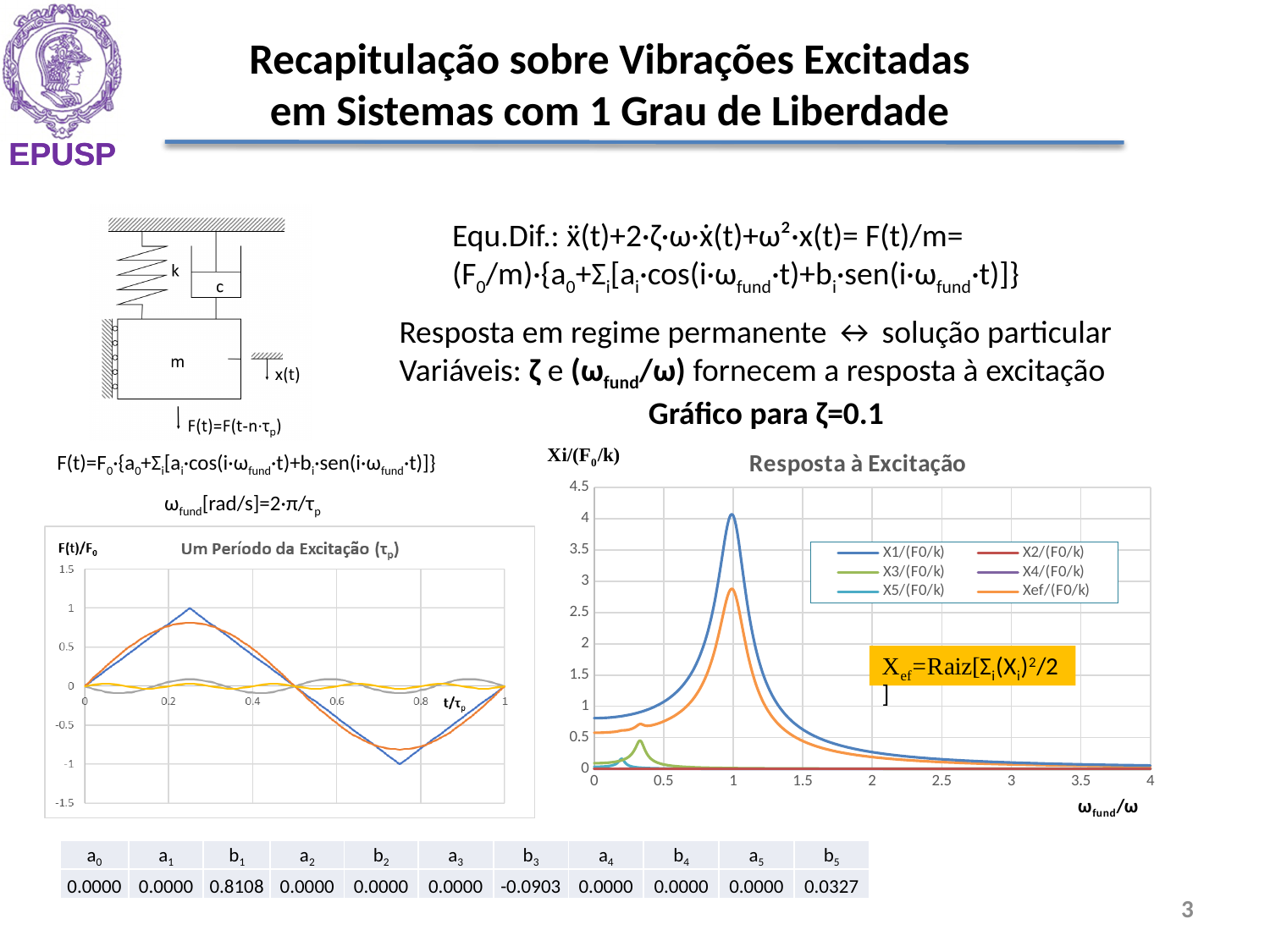
In the 'Resposta à Excitação' chart, at which ωfund/ω value does X1/(F0/k) reach its peak? 1 In the 'Resposta à Excitação' chart, which series reaches the highest peak? X1/(F0/k) In the 'Resposta à Excitação' chart, do the X1/(F0/k) values rise or fall as ωfund/ω increases from 1 to 4? fall What is the highest value shown on the vertical axis of the 'Resposta à Excitação' chart? 4.5 In the 'Um Período da Excitação (τp)' chart, is the value of the blue line at t/τp = 0.75 greater or less than -0.5? less What kind of chart is the 'Resposta à Excitação' chart? line chart What kind of chart is 'Um Período da Excitação (τp)'? line chart In the 'Resposta à Excitação' chart, is the peak value of Xef/(F0/k) greater or less than 2.5? greater How many series does the legend of the 'Resposta à Excitação' chart list? 6 In the 'Resposta à Excitação' chart, is the value of X1/(F0/k) at ωfund/ω = 4 greater or less than 0.5? less